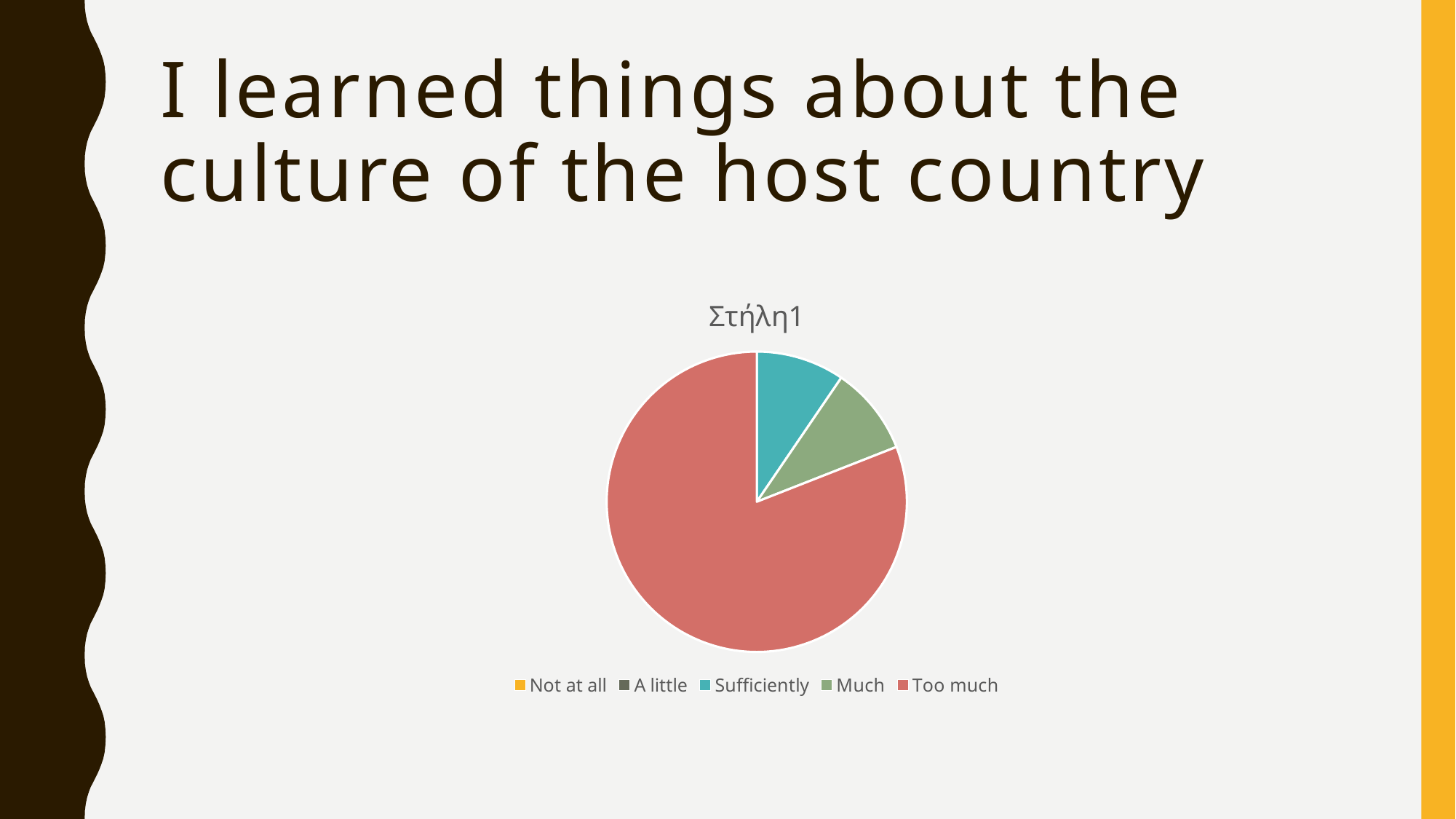
What is the title of the chart? Στήλη1 Does the slice for Too much take up more or less than half of the pie? more Which category is shown in red in the pie chart? Too much How many categories does the chart legend list? 5 Which category has the largest slice of the pie? Too much Which is larger, the slice for Too much or the slice for Much? Too much Which is larger, the slice for Too much or the slice for Sufficiently? Too much What kind of chart is shown on the slide? pie chart How many slices are visible in the pie chart? 3